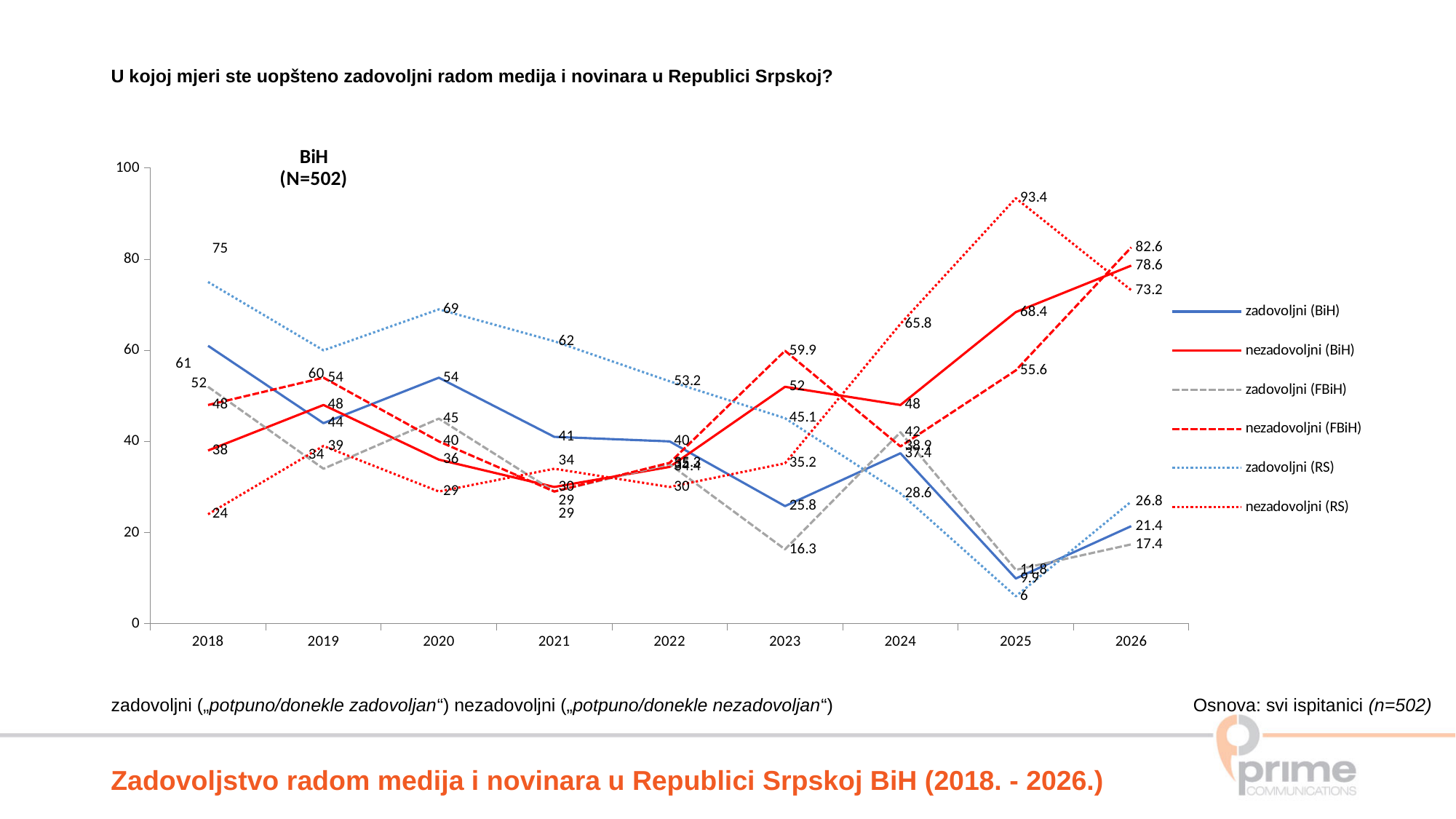
Does the zadovoljni (RS) series overall rise or fall from 2018 to 2026? fall How many series does the legend list? 6 What is the value for zadovoljni (BiH) in 2026? 21.4 Is the value for zadovoljni (FBiH) in 2023 greater or less than 20? less How many years are plotted along the x axis? 9 What is the value for nezadovoljni (RS) in 2025? 93.4 What is the value for zadovoljni (RS) in 2018? 75 In which year does zadovoljni (RS) reach its lowest value? 2025 In which year does nezadovoljni (RS) reach its highest value? 2025 Which is larger in 2025: nezadovoljni (BiH) or nezadovoljni (FBiH)? nezadovoljni (BiH) What kind of chart is shown on the slide? line chart What is the difference between nezadovoljni (FBiH) and zadovoljni (FBiH) in 2026? 65.2